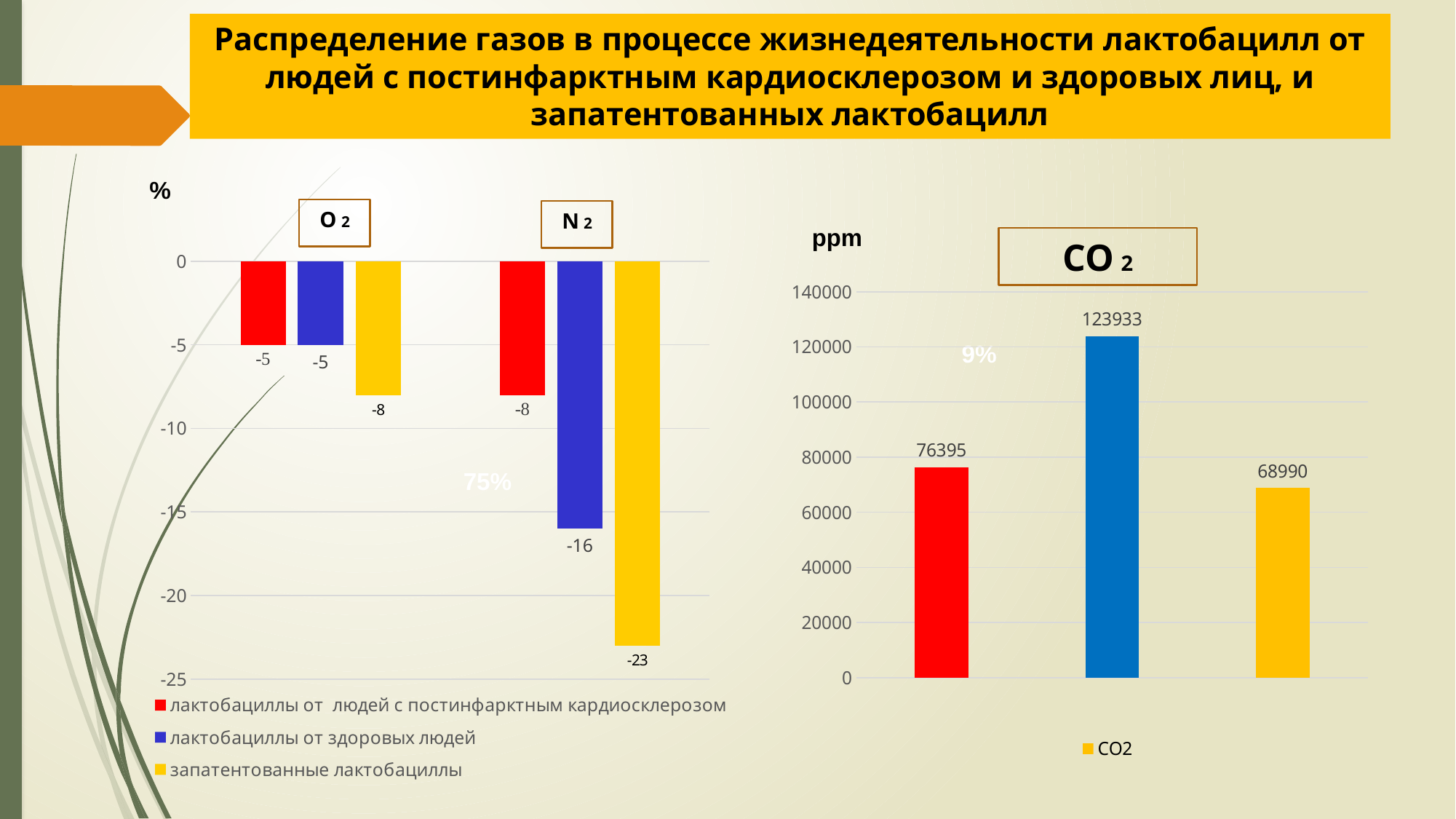
In the left chart (O₂ and N₂), what is the difference between the N₂ values for запатентованные лактобациллы and лактобациллы от людей с постинфарктным кардиосклерозом? 15 In the left chart (O₂ and N₂), which series has the lowest N₂ value? запатентованные лактобациллы In the right chart (CO₂), what is the value of the yellow bar? 68990 In the right chart (CO₂), what is the difference between the red bar and the yellow bar? 7405 In the left chart (O₂ and N₂), what is the O₂ value for лактобациллы от здоровых людей? -5 In the right chart (CO₂), which bar is the highest? the middle (blue) bar, 123933 In the right chart (CO₂), how many bars are plotted? 3 In the right chart (CO₂), what is the value of the middle (blue) bar? 123933 In the left chart (O₂ and N₂), what is the N₂ value for запатентованные лактобациллы? -23 In the left chart (O₂ and N₂), how many series does the legend list? 3 In the left chart (O₂ and N₂), what is the N₂ value for лактобациллы от здоровых людей? -16 What type of chart is the right chart (CO₂)? bar chart